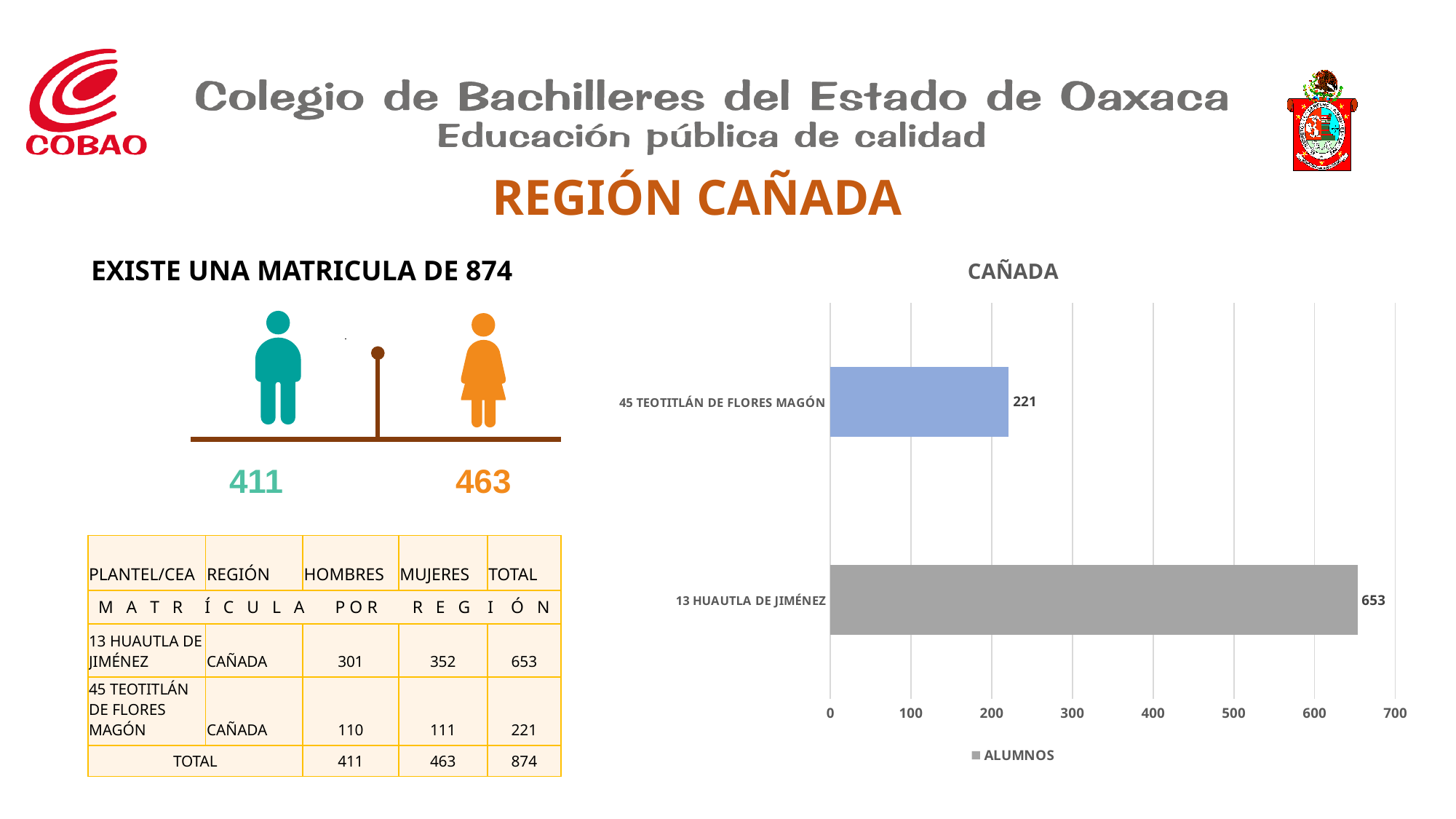
What is the value for 13 HUAUTLA DE JIMÉNEZ in the CAÑADA chart? 653 What is the value for 45 TEOTITLÁN DE FLORES MAGÓN in the CAÑADA chart? 221 What is the difference between the values for 13 HUAUTLA DE JIMÉNEZ and 45 TEOTITLÁN DE FLORES MAGÓN in the CAÑADA chart? 432 How many categories are shown in the CAÑADA chart? 2 What kind of chart is the CAÑADA chart? bar chart In the CAÑADA chart, which is larger: the value for 13 HUAUTLA DE JIMÉNEZ or the value for 45 TEOTITLÁN DE FLORES MAGÓN? 13 HUAUTLA DE JIMÉNEZ Which category has the lowest value in the CAÑADA chart? 45 TEOTITLÁN DE FLORES MAGÓN What is the name of the series in the legend of the CAÑADA chart? ALUMNOS Is the value for 45 TEOTITLÁN DE FLORES MAGÓN in the CAÑADA chart greater or less than 300? less Which category has the highest value in the CAÑADA chart? 13 HUAUTLA DE JIMÉNEZ How many series does the legend of the CAÑADA chart list? 1 Is the value for 13 HUAUTLA DE JIMÉNEZ in the CAÑADA chart greater or less than 600? greater